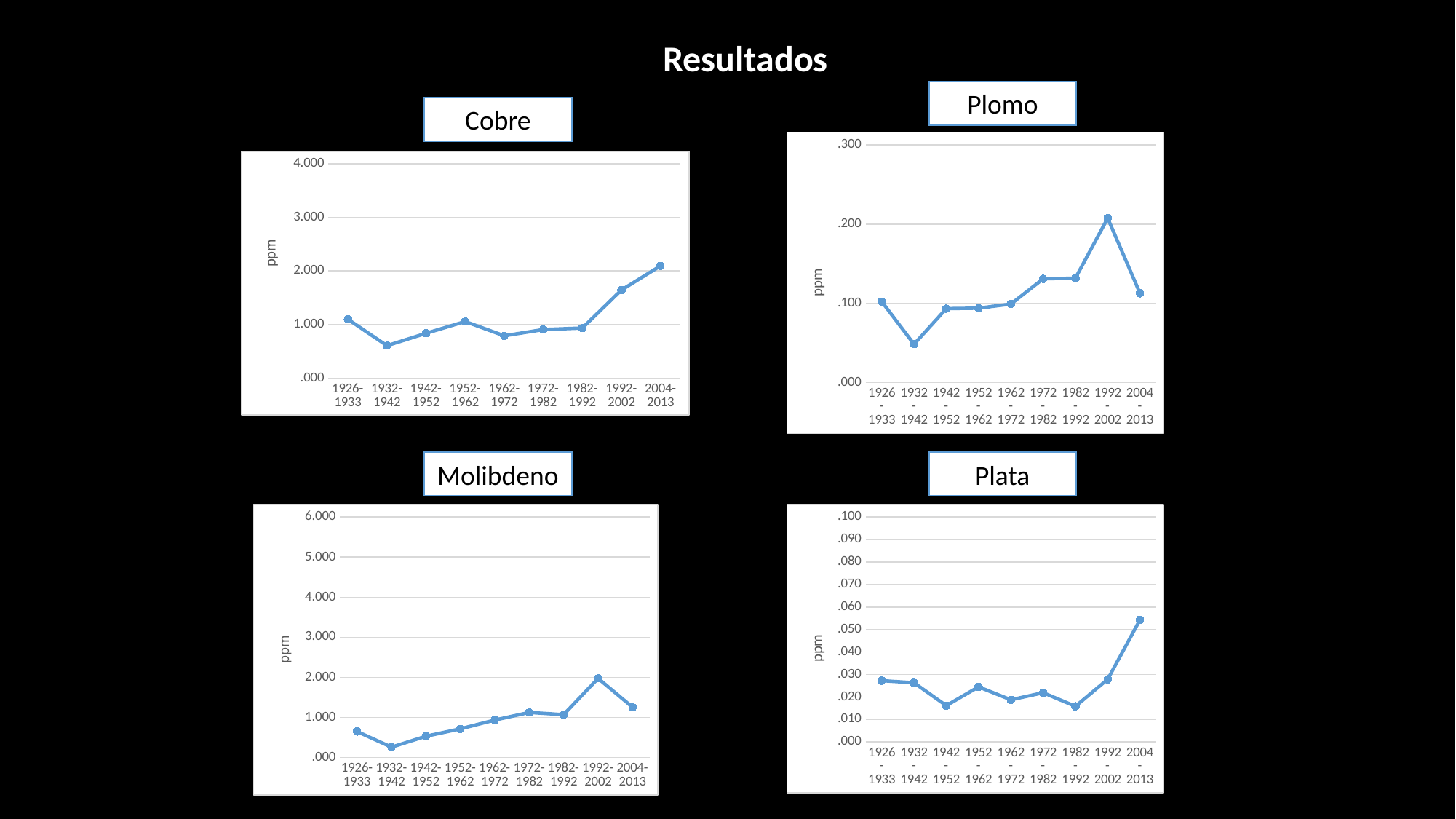
In the Plomo chart, is the value for 1932-1942 greater or less than .100? less In the Plomo chart, which period has the highest value? 1992-2002 In the Plata chart, is the value for 2004-2013 greater or less than .040? greater In the Plomo chart, which period has the lowest value? 1932-1942 What unit is shown on the y axis of the Molibdeno chart? ppm In the Molibdeno chart, which period has the highest value? 1992-2002 In the Cobre chart, which period has the highest value? 2004-2013 How many time periods are plotted on the Plomo chart? 9 What kind of chart is the Cobre chart? line chart In the Cobre chart, is the value for 1992-2002 greater or less than 1.000? greater In the Cobre chart, which period has the lowest value? 1932-1942